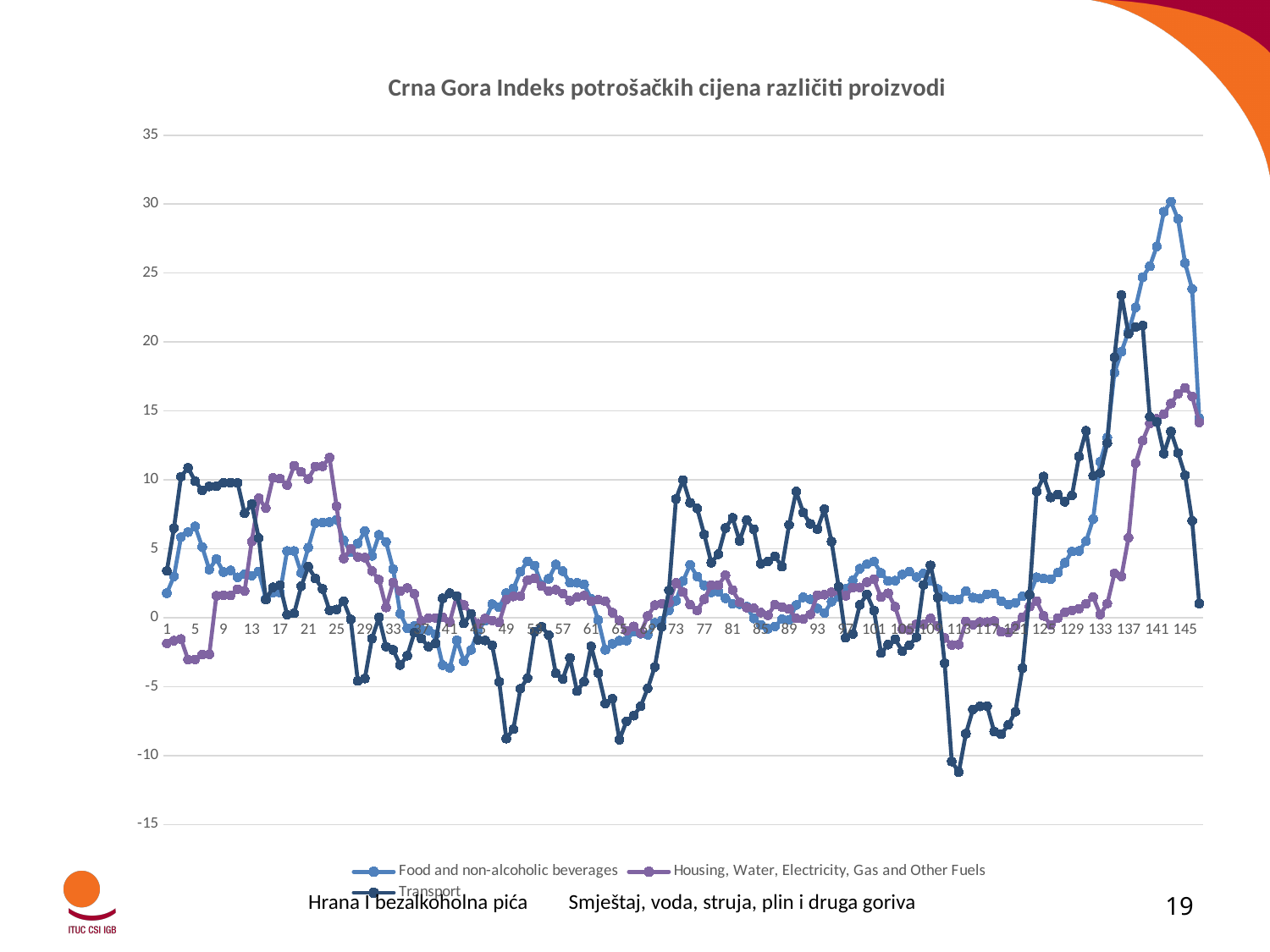
At x = 137, which series is higher: Transport or Housing, Water, Electricity, Gas and Other Fuels? Transport What is the highest value shown on the vertical axis? 35 Which series reaches the highest value anywhere on the chart? Food and non-alcoholic beverages What kind of chart is shown on the slide? line chart At x = 1, which series is higher: Food and non-alcoholic beverages or Housing, Water, Electricity, Gas and Other Fuels? Food and non-alcoholic beverages Which series reaches the lowest value anywhere on the chart? Transport Is the peak value of the Housing, Water, Electricity, Gas and Other Fuels series greater or less than 20? less Is the peak value of the Food and non-alcoholic beverages series greater or less than 25? greater Between x = 125 and x = 141, does the Food and non-alcoholic beverages series rise or fall? rise How many series does the legend list? 3 What is the title of the chart? Crna Gora Indeks potrošačkih cijena različiti proizvodi Is the lowest value of the Transport series greater or less than -10? less